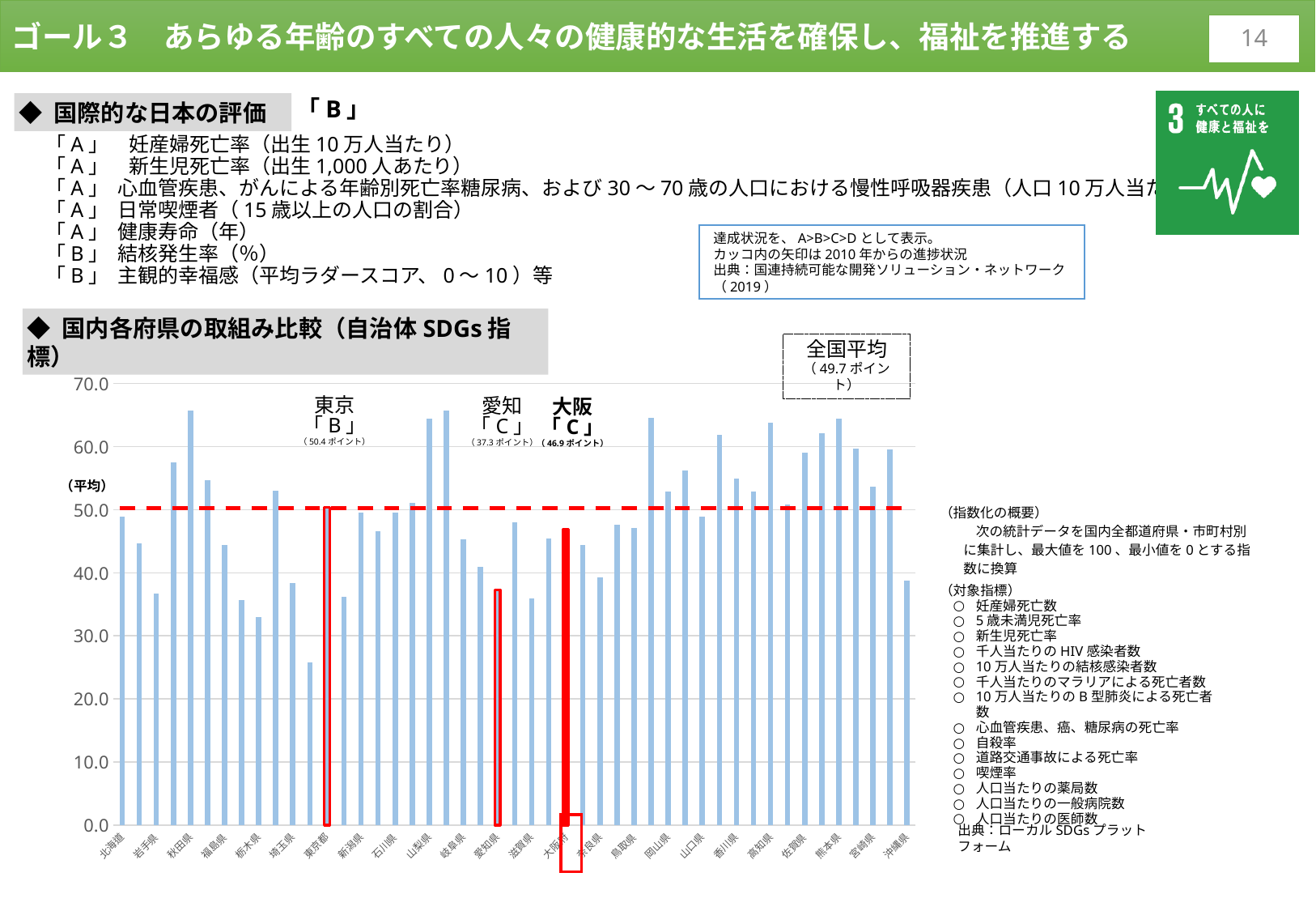
What is the value shown for 愛知 on the chart? 37.3 ポイント What is the difference between the values for 東京 and 愛知? 13.1 ポイント Which is larger, the value for 大阪 or the 全国平均? 全国平均 Is the value for 栃木県 greater or less than 40.0? less What is the difference between the values for 大阪 and 愛知? 9.6 ポイント What is the value shown for 東京 on the chart? 50.4 ポイント What is the value shown for 大阪 on the chart? 46.9 ポイント Is the value for 秋田県 greater or less than 60.0? greater What does the red dashed horizontal line on the chart represent? 全国平均 Which has the larger value, 東京 or 大阪? 東京 What is the 全国平均 value shown on the chart? 49.7 ポイント What kind of chart is shown on the slide? bar chart